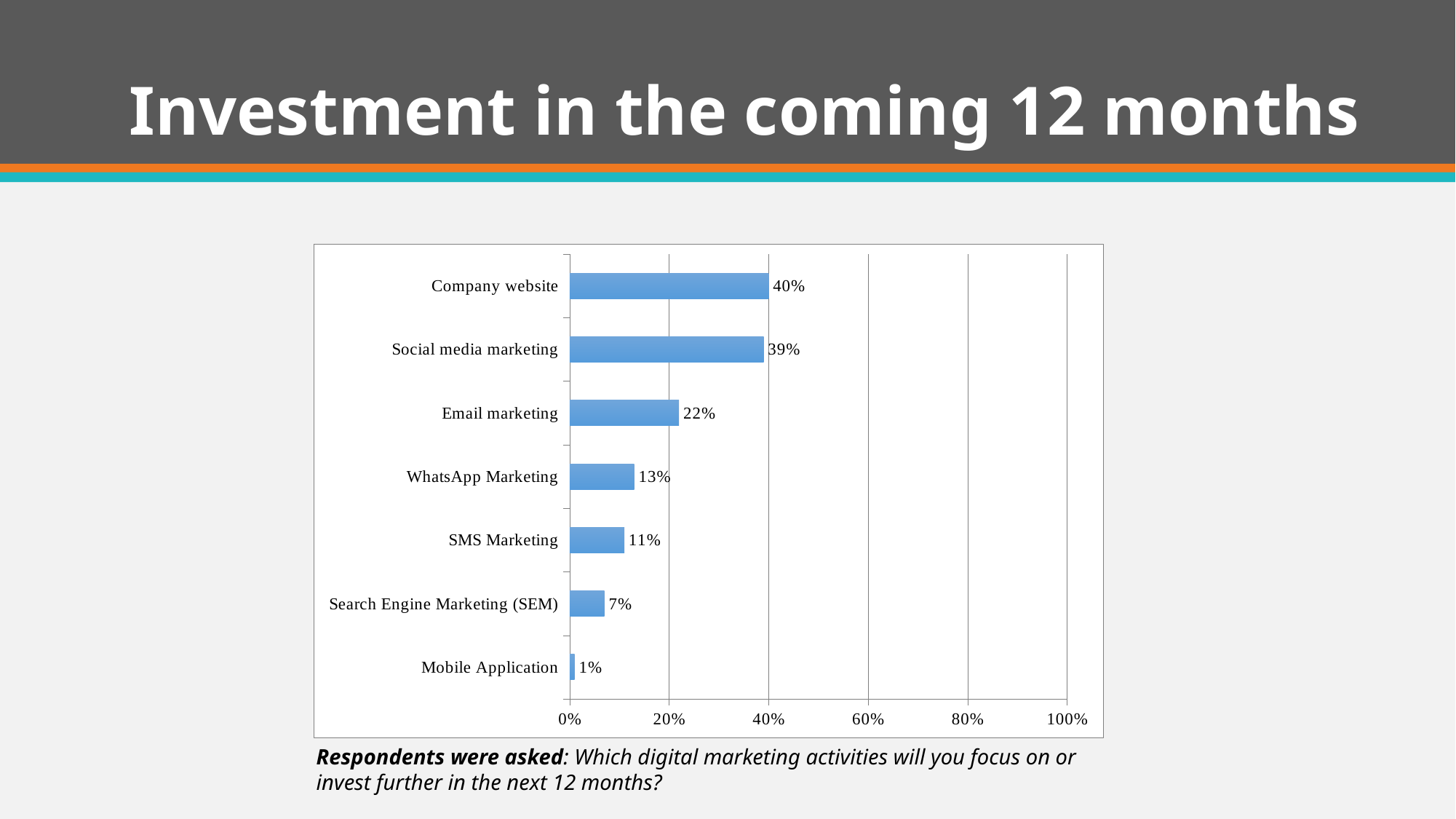
Which category has the lowest value? Mobile Application What is the value for Company website? 40% What is the difference between the values for Email marketing and WhatsApp Marketing? 9% Is the value for Social media marketing greater or less than 20%? greater What is the difference between the values for Company website and Mobile Application? 39% Which is larger, the value for SMS Marketing or the value for Search Engine Marketing (SEM)? SMS Marketing What is the value for Email marketing? 22% What kind of chart is shown on the slide? bar chart What is the title of the slide containing the chart? Investment in the coming 12 months What is the value for Search Engine Marketing (SEM)? 7% How many categories are shown in the chart? 7 Which category has the highest value? Company website